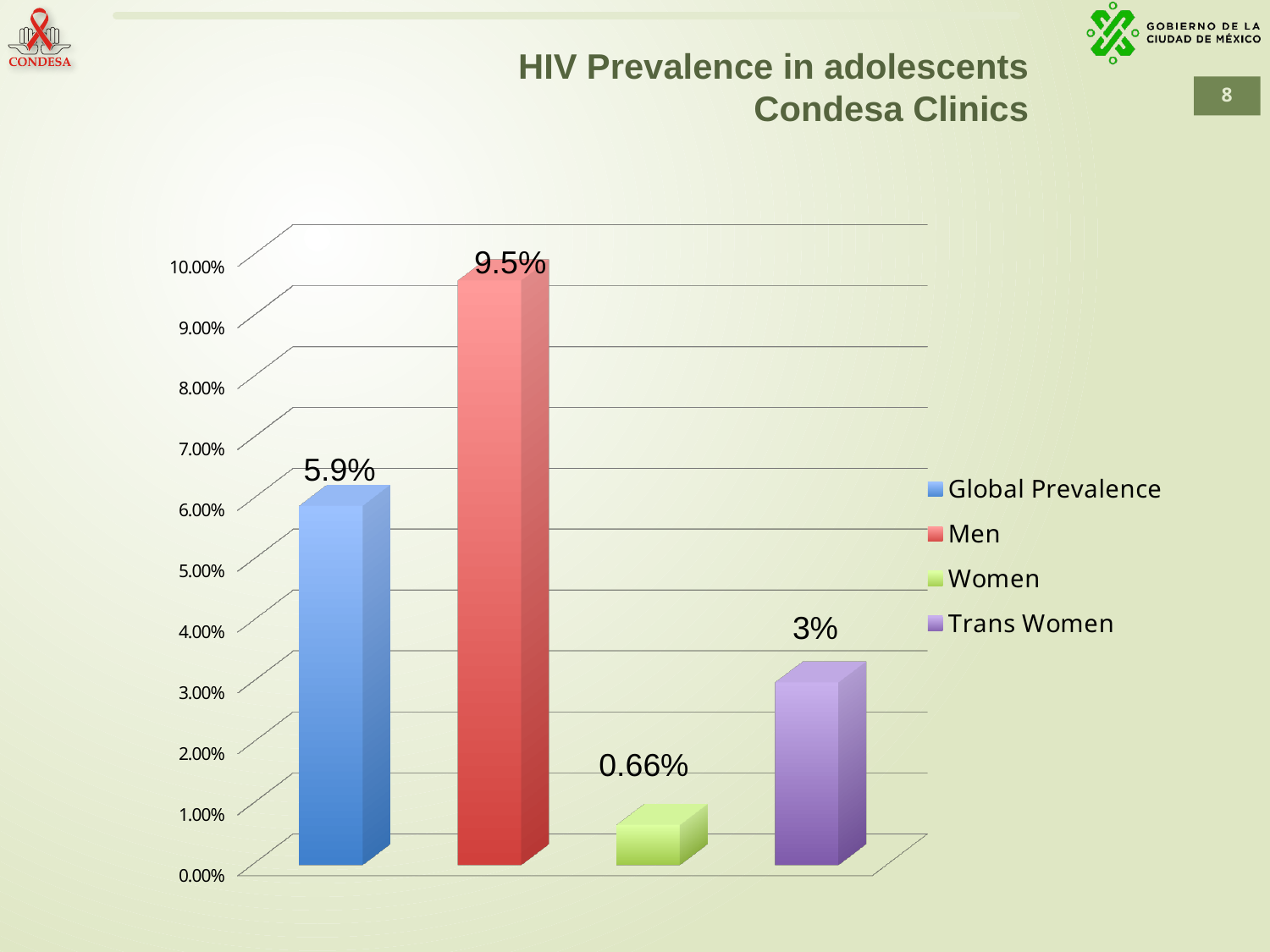
What is the difference between the value for Trans Women and the value for Women? 2.34% What is the value shown for Global Prevalence? 5.9% What kind of chart is shown on the slide? Bar chart What is the value shown for Trans Women? 3% How many bars are plotted in the chart? 4 Which is larger, the value for Global Prevalence or the value for Trans Women? Global Prevalence What is the value shown for Women? 0.66% Which group has the lowest HIV prevalence in the chart? Women What is the HIV prevalence value shown for Men? 9.5% What is the difference between the value for Men and the Global Prevalence value? 3.6% Which group has the highest HIV prevalence in the chart? Men How many entries does the legend list? 4